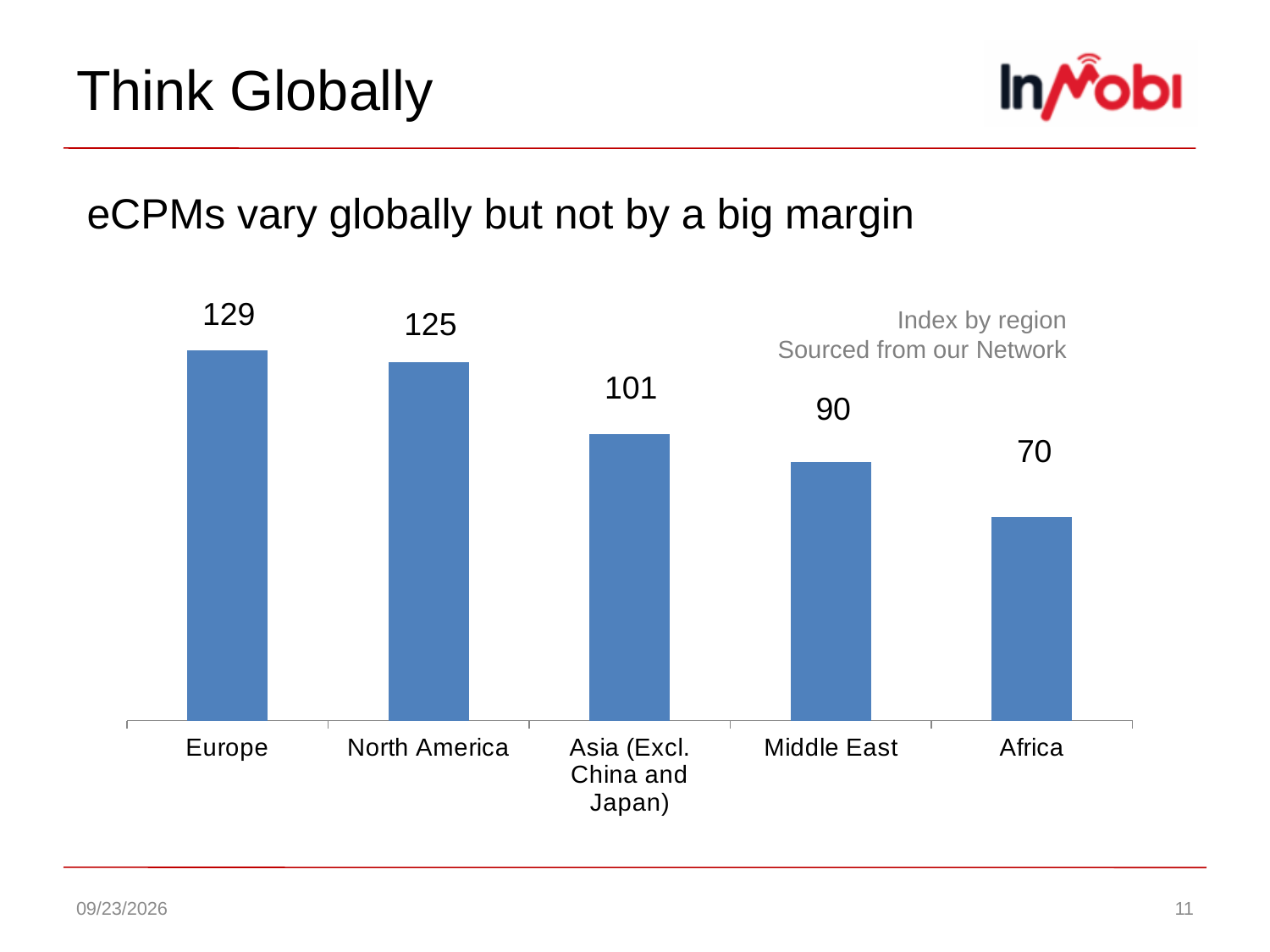
What is the index value for Europe? 129 What is the index value for Africa? 70 Which has a higher index value, Asia (Excl. China and Japan) or Middle East? Asia (Excl. China and Japan) How many regions are shown in the chart? 5 What is the difference between the index values for Europe and Africa? 59 What is the index value for Middle East? 90 Which region has the lowest index value? Africa What is the index value for North America? 125 What is the difference between the index values for North America and Middle East? 35 What is the index value for Asia (Excl. China and Japan)? 101 Which region has the highest index value? Europe What kind of chart is shown on the slide? Bar chart